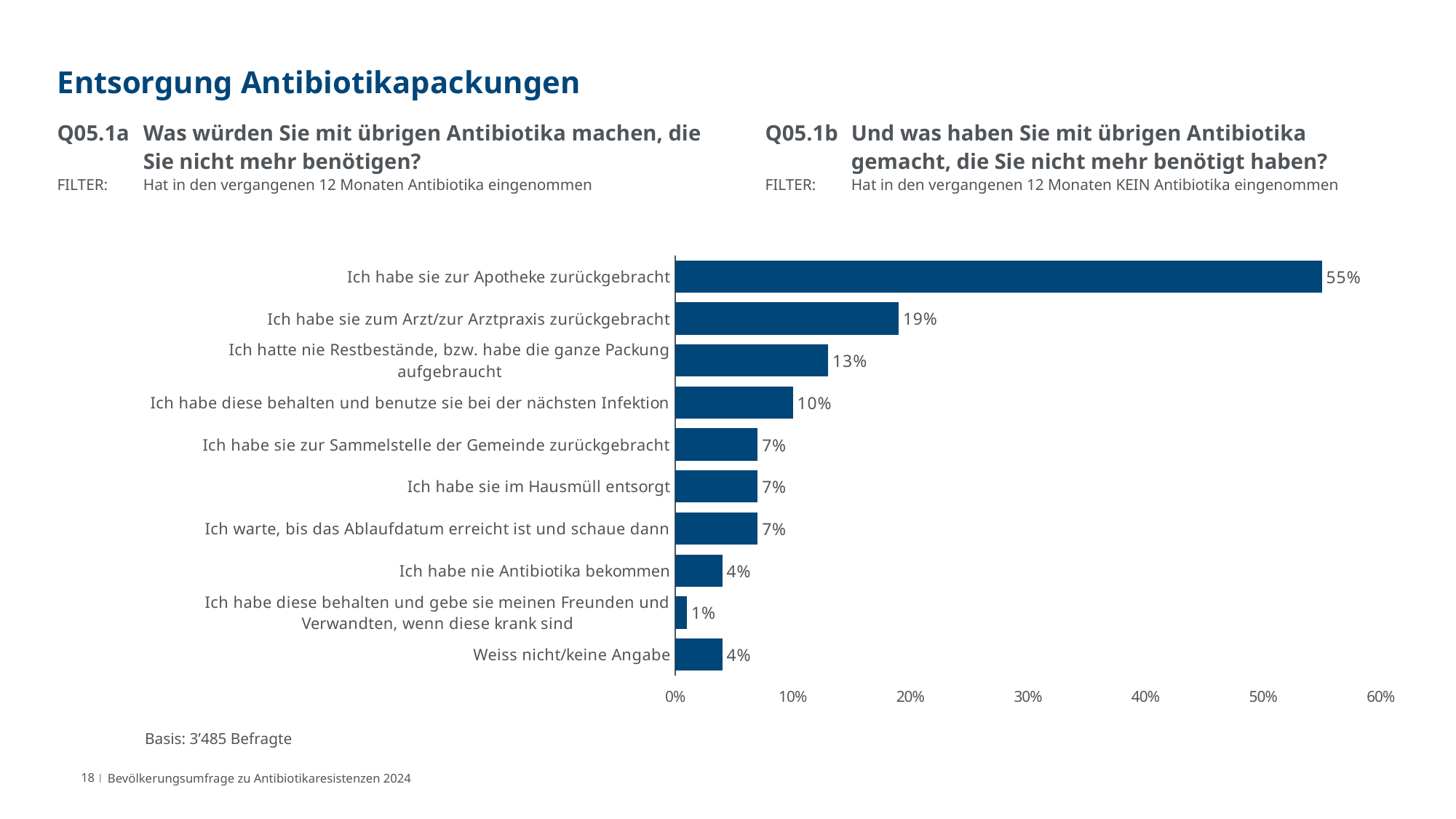
What kind of chart is shown on the slide? Bar chart Which category has the lowest value in the chart? Ich habe diese behalten und gebe sie meinen Freunden und Verwandten, wenn diese krank sind Which category has the highest value in the chart? Ich habe sie zur Apotheke zurückgebracht Is the value for "Ich habe sie zur Apotheke zurückgebracht" greater or less than 50%? greater Which is larger: the value for "Ich hatte nie Restbestände, bzw. habe die ganze Packung aufgebraucht" or the value for "Ich habe diese behalten und benutze sie bei der nächsten Infektion"? Ich hatte nie Restbestände, bzw. habe die ganze Packung aufgebraucht How many categories are shown in the chart? 10 What percentage of respondents said they brought leftover antibiotics back to the pharmacy ("Ich habe sie zur Apotheke zurückgebracht")? 55% What is the basis (number of respondents) stated below the chart? 3'485 Befragte What is the value for "Ich habe sie im Hausmüll entsorgt"? 7% What is the difference between the value for "Ich habe sie zur Apotheke zurückgebracht" and the value for "Ich habe sie zum Arzt/zur Arztpraxis zurückgebracht"? 36 percentage points What is the value for "Ich habe diese behalten und benutze sie bei der nächsten Infektion"? 10% What is the value for "Ich habe sie zum Arzt/zur Arztpraxis zurückgebracht"? 19%